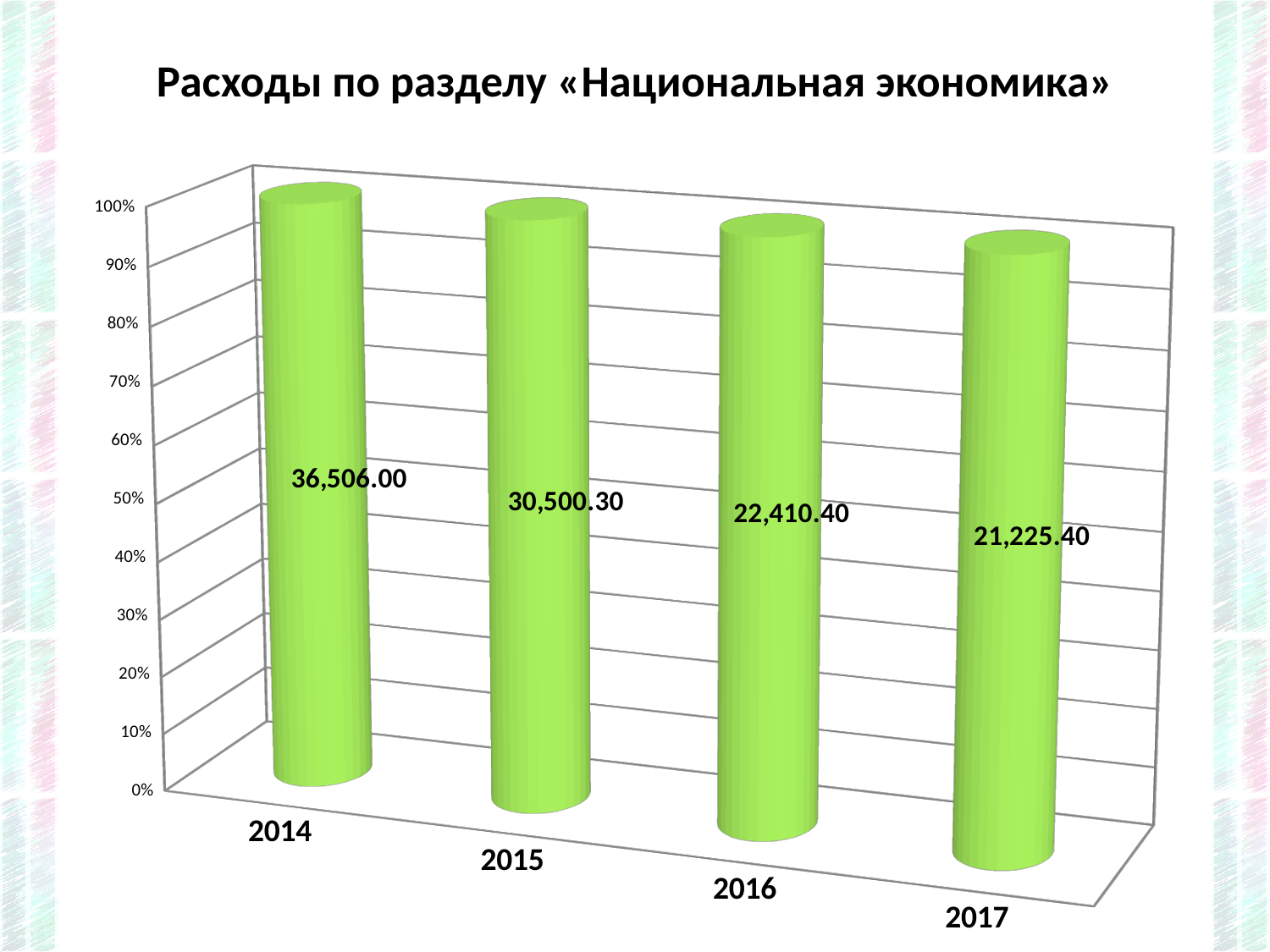
What is the data label for 2014? 36,506.00 Which year has the highest labelled value? 2014 What kind of chart is shown on the slide? Bar chart Do the labelled values rise or fall from 2014 to 2017? Fall What is the data label for 2017? 21,225.40 What is the data label for 2016? 22,410.40 What is the difference between the labelled values for 2016 and 2017? 1,185.00 Which year has the lowest labelled value? 2017 What is the difference between the labelled values for 2014 and 2015? 6,005.70 What is the data label for 2015? 30,500.30 Which has the larger labelled value, 2015 or 2016? 2015 How many years are shown on the x axis? 4